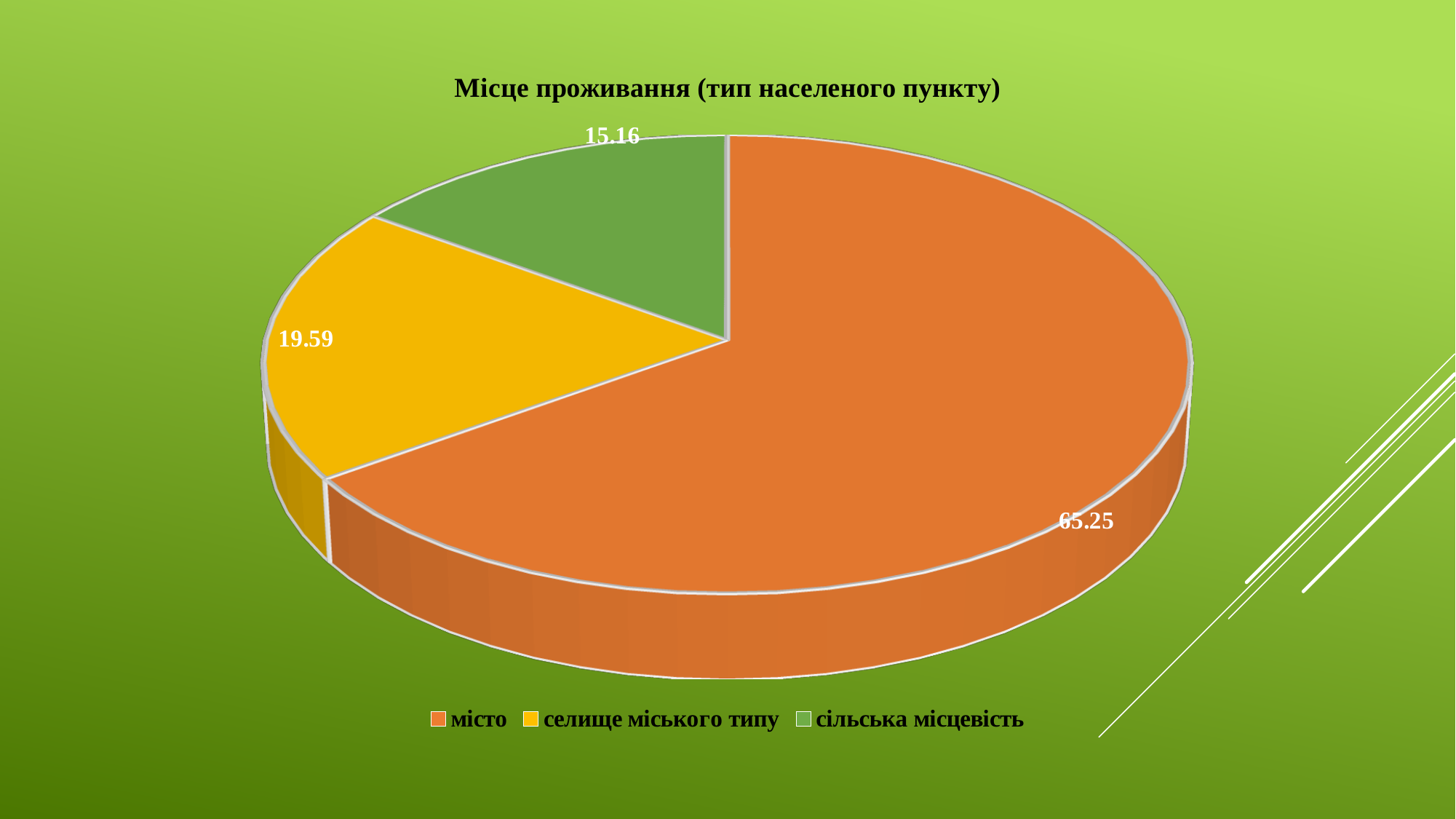
What is the title of the chart? Місце проживання (тип населеного пункту) How many categories does the pie chart show? 3 What colour is the slice for сільська місцевість? green What is the difference between the values for місто and селище міського типу? 45.66 What is the value for місто? 65.25 Which category has the smallest slice? сільська місцевість What kind of chart is shown on the slide? pie chart What is the value for селище міського типу? 19.59 What is the difference between the values for селище міського типу and сільська місцевість? 4.43 Which is larger, the value for селище міського типу or the value for сільська місцевість? селище міського типу Which category has the largest slice? місто What is the value for сільська місцевість? 15.16